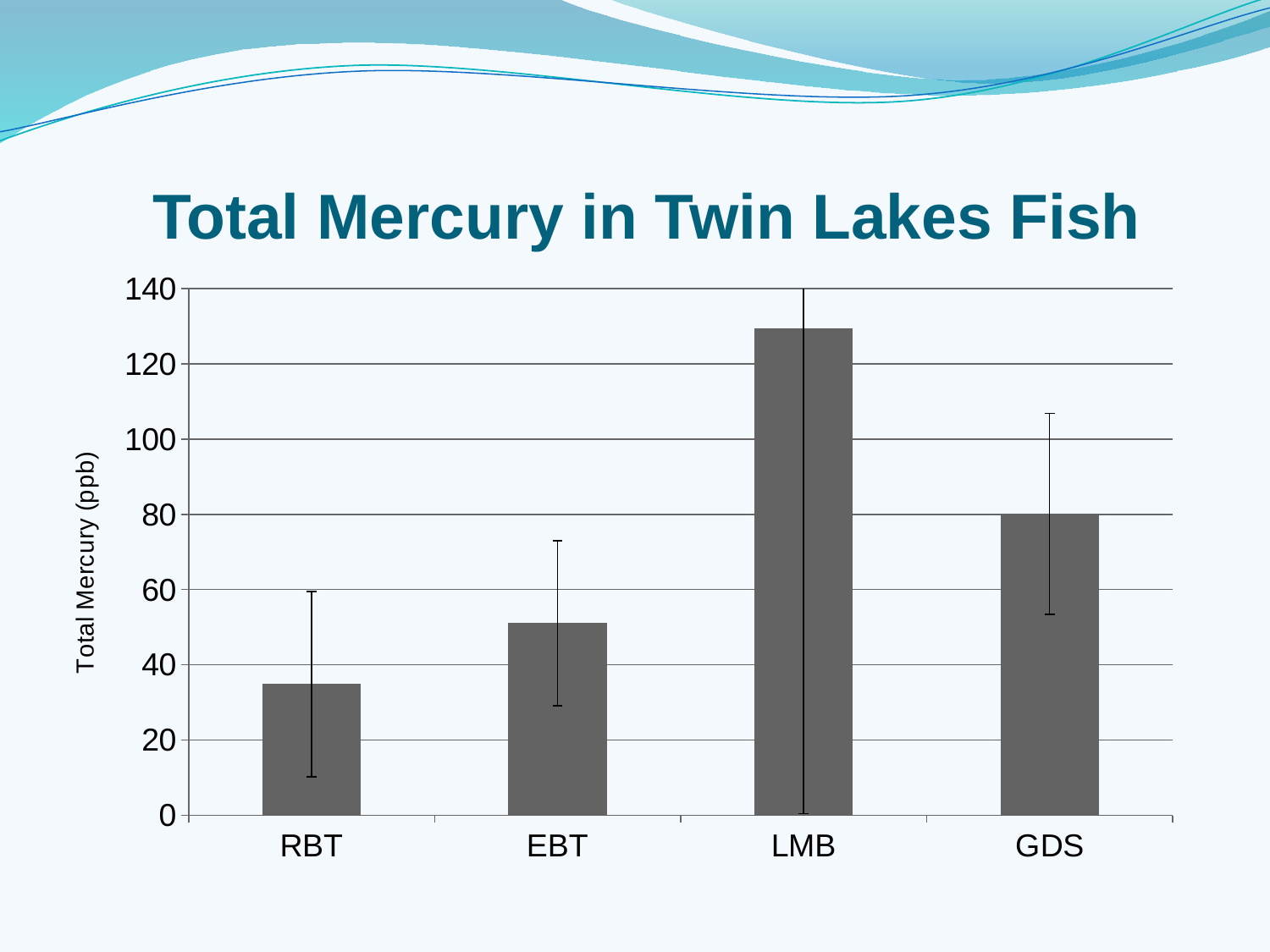
Is the value for EBT greater or less than 60? less Which has a higher total mercury value, RBT or EBT? EBT Is the value for EBT greater or less than 40? greater What is the label on the y axis? Total Mercury (ppb) What kind of chart is shown on the slide? bar chart What is the title of the chart? Total Mercury in Twin Lakes Fish Is the value for LMB greater or less than 120? greater How many fish categories are plotted on the x axis? 4 Which fish category has the lowest total mercury? RBT Which fish category has the highest total mercury? LMB Which has a higher total mercury value, EBT or GDS? GDS